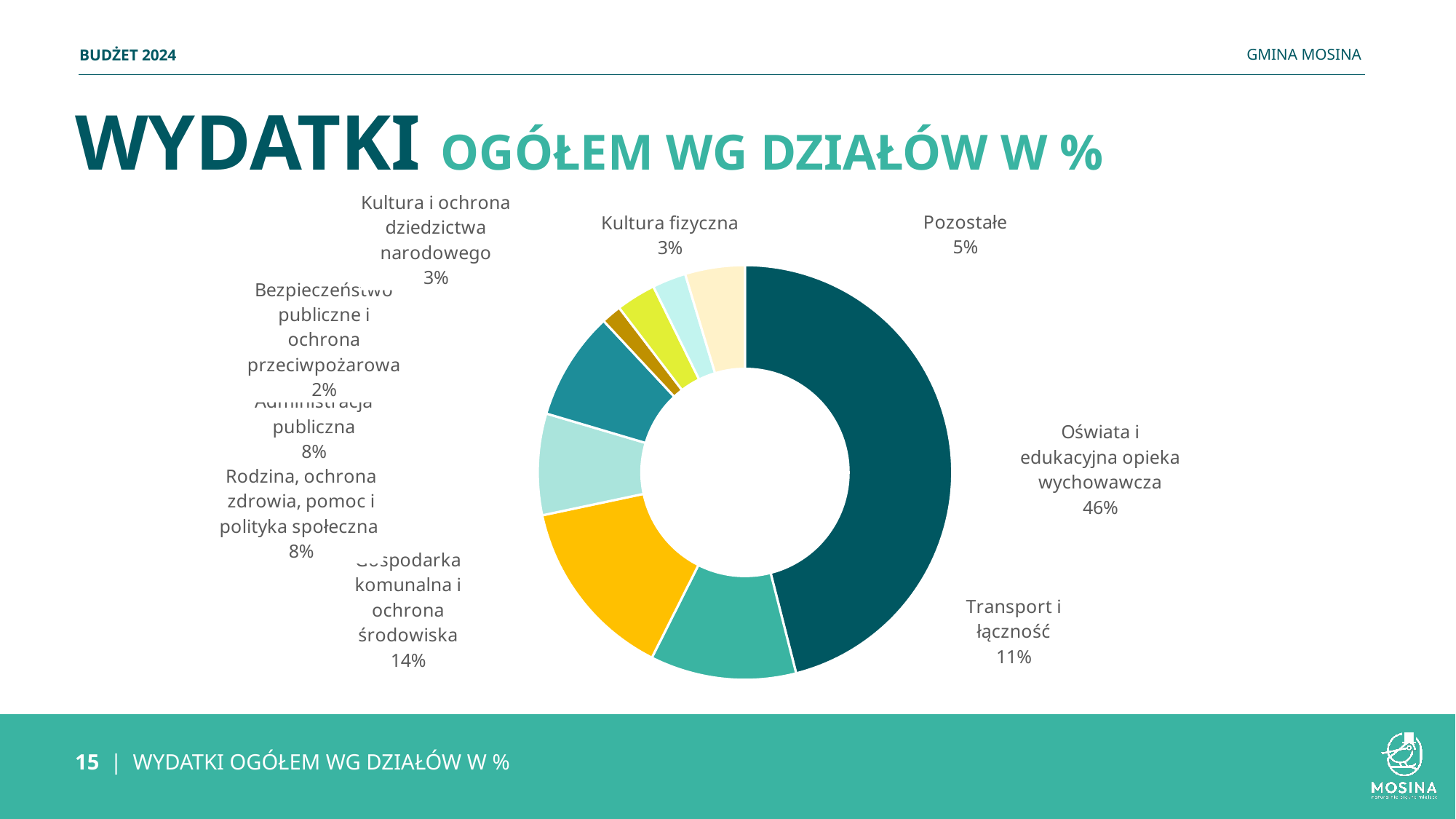
What share of the chart does Oświata i edukacyjna opieka wychowawcza represent? 46% What percentage is shown for Gospodarka komunalna i ochrona środowiska? 14% Which category has the smallest share of the chart? Bezpieczeństwo publiczne i ochrona przeciwpożarowa What is the title of the slide? WYDATKI OGÓŁEM WG DZIAŁÓW W % How many categories are shown in the chart? 9 Which is larger, Transport i łączność or Gospodarka komunalna i ochrona środowiska? Gospodarka komunalna i ochrona środowiska What kind of chart is shown on the slide? Pie chart (donut) What percentage is shown for Pozostałe? 5% What percentage is shown for Transport i łączność? 11% What is the difference in percentage points between Oświata i edukacyjna opieka wychowawcza and Gospodarka komunalna i ochrona środowiska? 32 Which category has the largest share of the chart? Oświata i edukacyjna opieka wychowawcza What percentage is shown for Kultura fizyczna? 3%